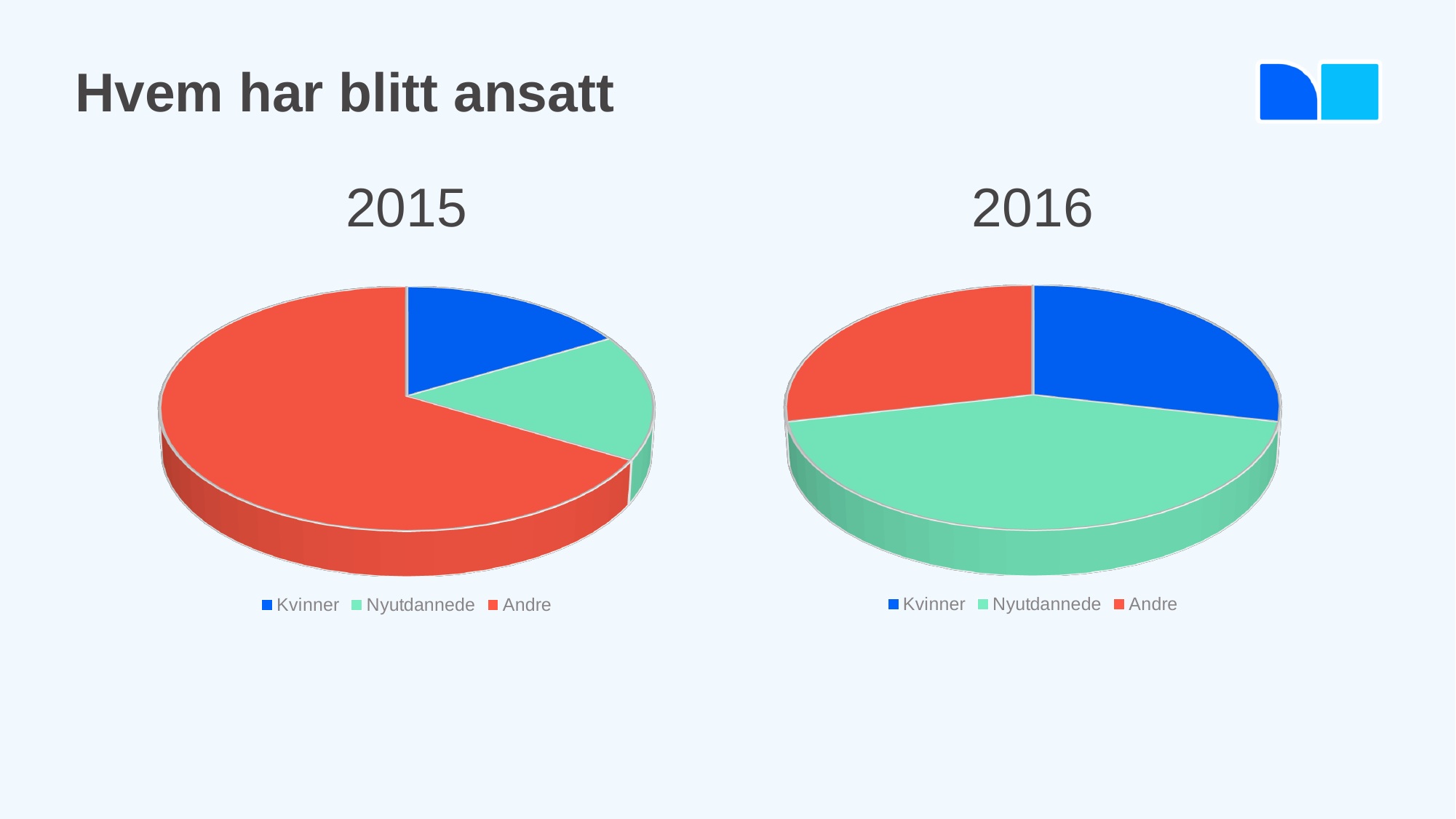
What kind of chart is the 2016 chart? pie chart What is the title of the slide containing the two pie charts? Hvem har blitt ansatt How many entries does the legend of the 2016 chart list? 3 In the 2015 chart, which slice is larger: Andre or Nyutdannede? Andre In the 2016 chart, which slice is larger: Nyutdannede or Kvinner? Nyutdannede In the 2015 chart, which category has the largest slice? Andre In the 2016 chart, which category has the largest slice? Nyutdannede How many slices does the 2015 pie chart have? 3 What kind of chart is the 2015 chart? pie chart In the 2016 chart, what colour represents the Andre category? red